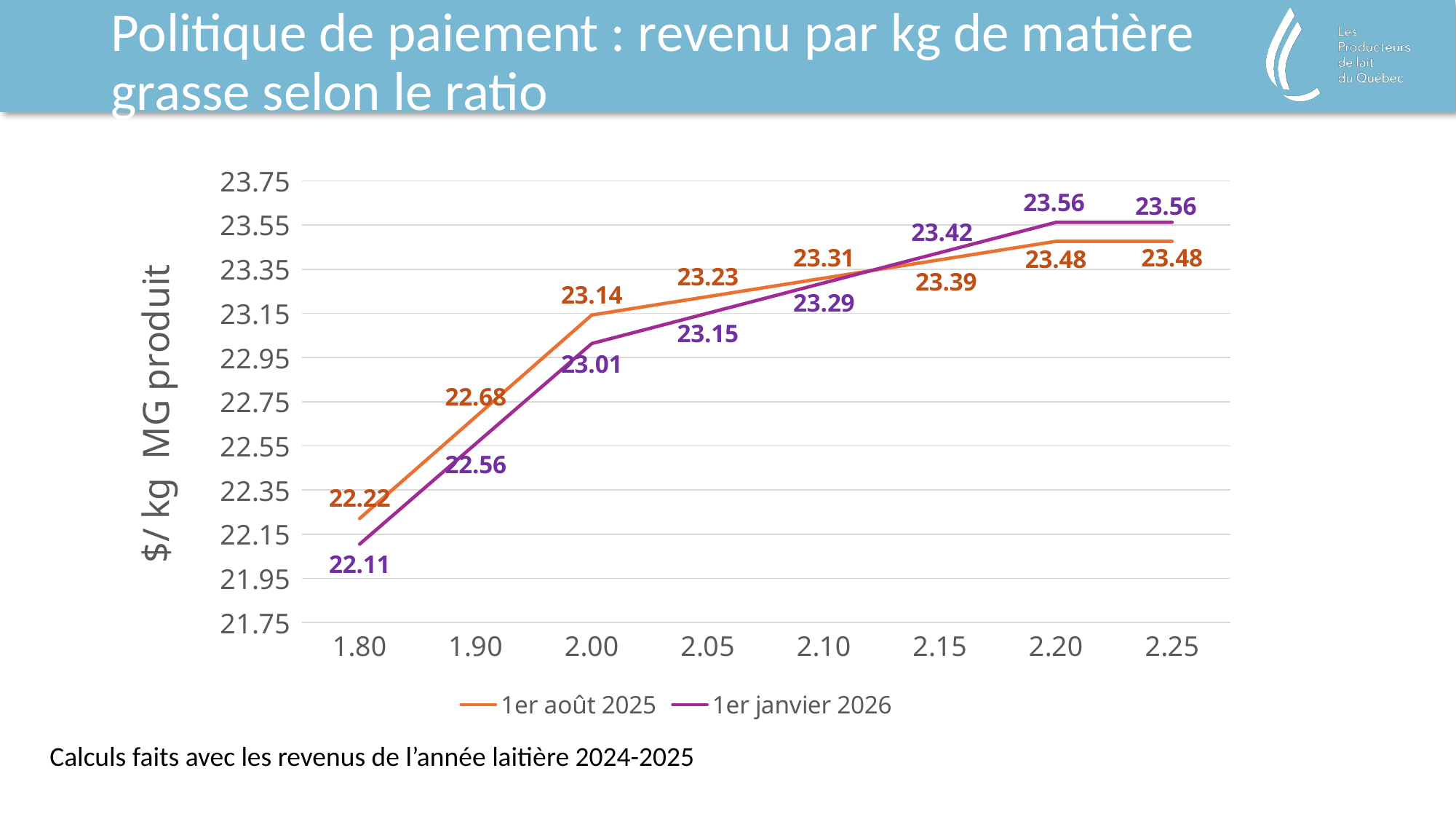
What is the difference between the 1er août 2025 and 1er janvier 2026 values at ratio 1.90? 0.12 What is the value for the 1er janvier 2026 series at ratio 2.15? 23.42 What is the highest value reached by the 1er janvier 2026 series? 23.56 What is the value for the 1er août 2025 series at ratio 2.00? 23.14 How many ratio values are plotted along the x axis? 8 What type of chart is shown on the slide? line chart At which ratio is the 1er août 2025 series lowest? 1.80 Do the values of the 1er janvier 2026 series rise or fall as the ratio increases from 1.80 to 2.20? rise What is the value for the 1er janvier 2026 series at ratio 1.80? 22.11 How many series does the legend list? 2 At ratio 2.20, which series has the larger value, 1er août 2025 or 1er janvier 2026? 1er janvier 2026 What is the label of the y axis? $/ kg MG produit